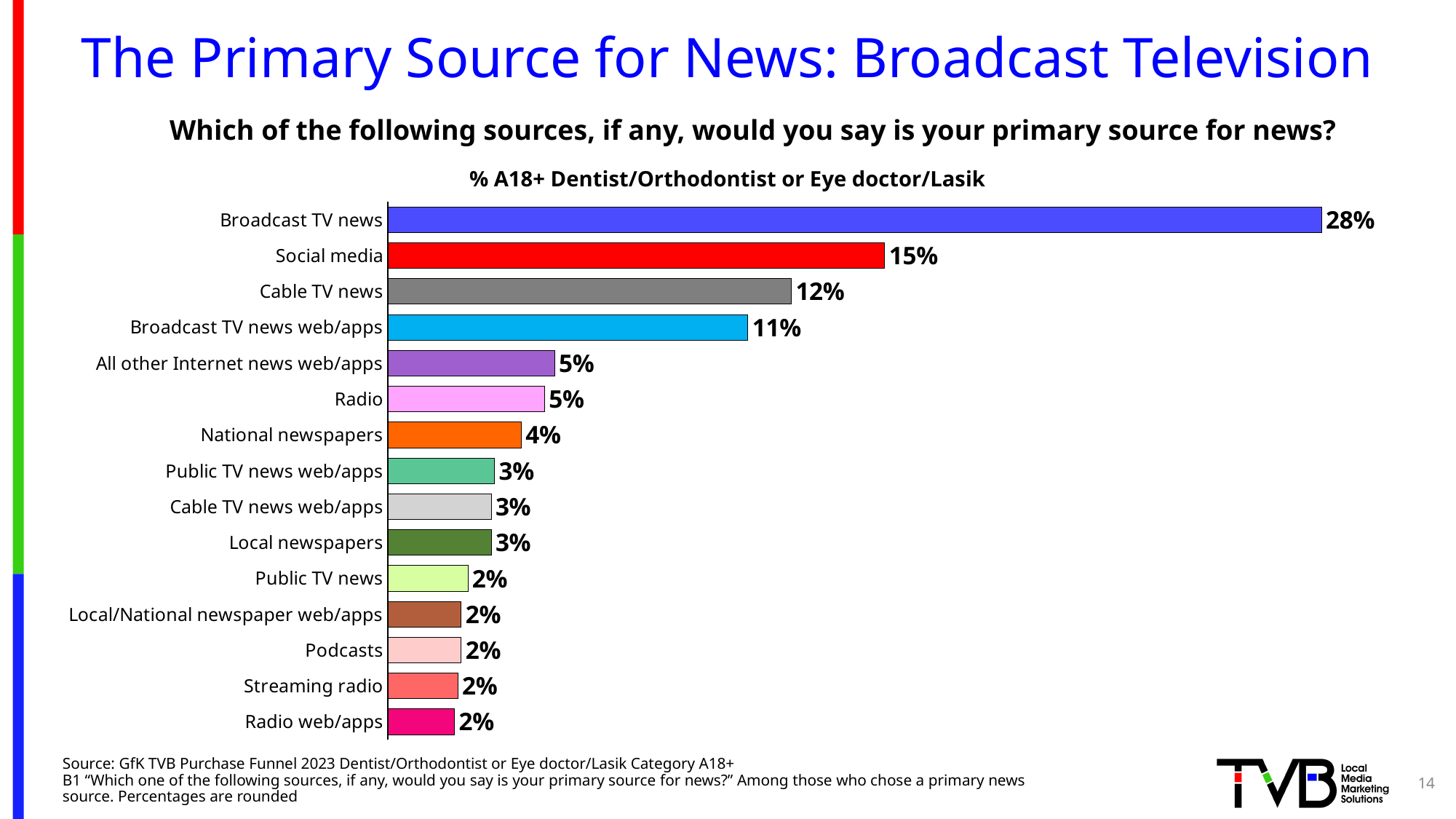
Which news source has the highest percentage in the chart? Broadcast TV news What percentage is shown for Broadcast TV news web/apps? 11% Which is larger, All other Internet news web/apps or National newspapers? All other Internet news web/apps What percentage of respondents named Broadcast TV news as their primary source for news? 28% How many news source categories are shown in the chart? 15 Which has a larger value, Cable TV news or Social media? Social media What is the value shown for Social media? 15% What type of chart is shown on the slide? Bar chart What is the value for National newspapers? 4% What is the difference in percentage points between Broadcast TV news and Social media? 13 What is the difference between Cable TV news and Broadcast TV news web/apps? 1 What is the title of the chart? % A18+ Dentist/Orthodontist or Eye doctor/Lasik